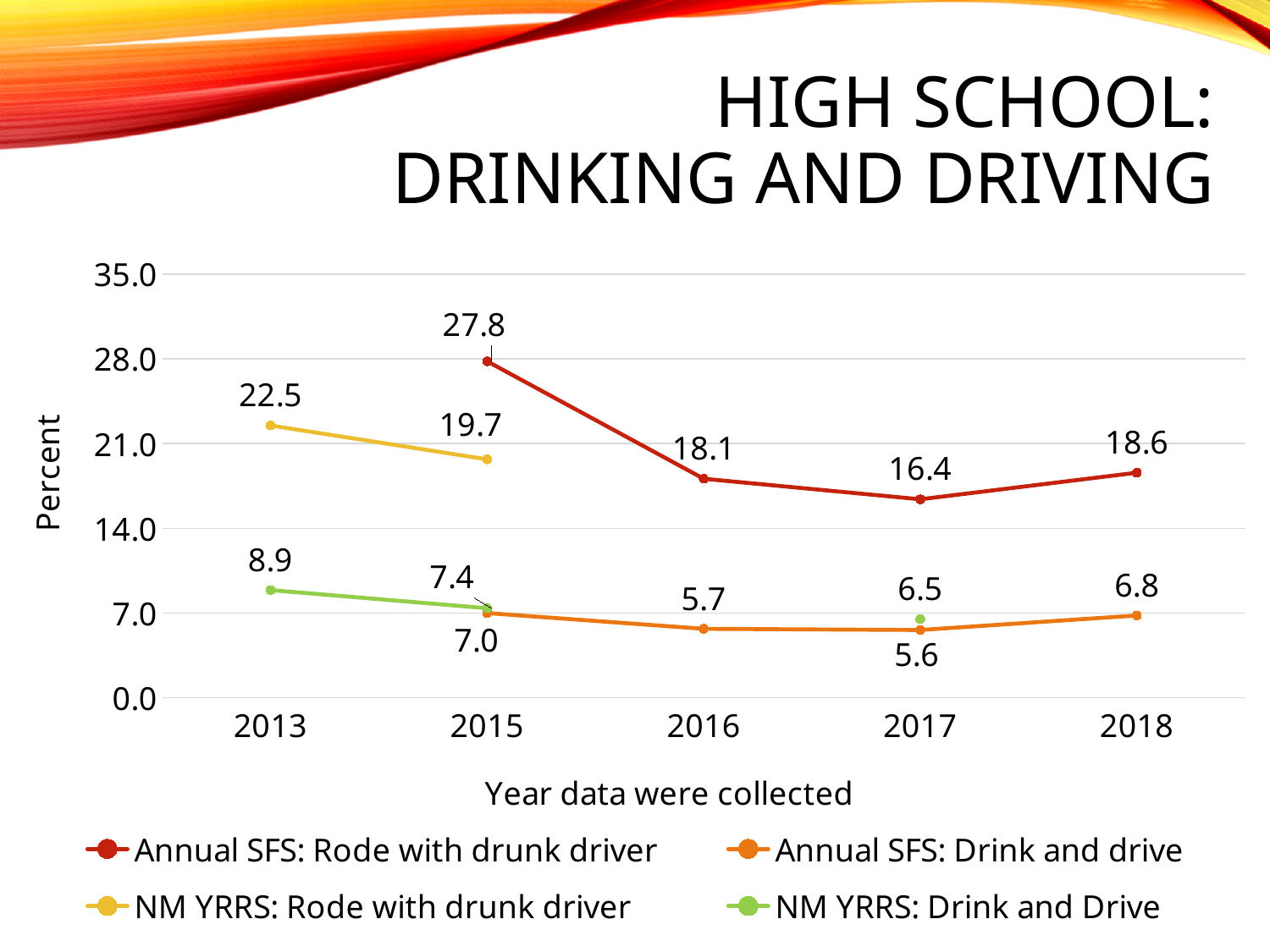
What is the value for NM YRRS: Rode with drunk driver in 2013? 22.5 What is the difference between the Annual SFS: Rode with drunk driver values in 2015 and 2018? 9.2 In which year is the Annual SFS: Drink and drive series lowest? 2017 What kind of chart is shown on the slide? Line chart By how much did NM YRRS: Rode with drunk driver fall from 2013 to 2015? 2.8 How many series does the legend list? 4 Does the Annual SFS: Rode with drunk driver series rise or fall from 2015 to 2017? Fall In which year is the Annual SFS: Rode with drunk driver series highest? 2015 In 2015, which is larger: NM YRRS: Drink and Drive or Annual SFS: Drink and drive? NM YRRS: Drink and Drive What is the value for Annual SFS: Rode with drunk driver in 2015? 27.8 How many years are shown on the x axis? 5 What is the value for Annual SFS: Drink and drive in 2016? 5.7